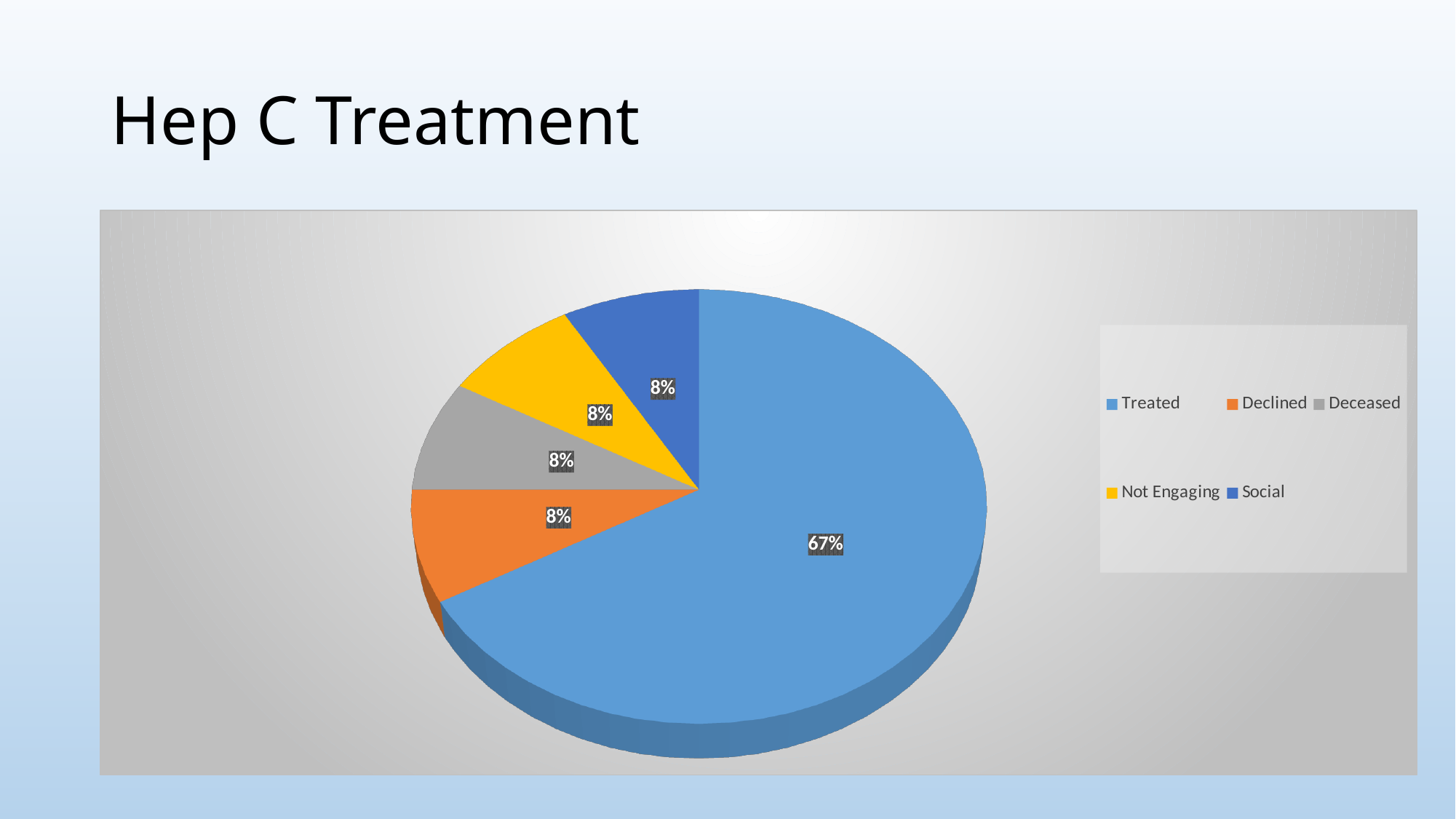
What share of the pie does the Deceased slice represent? 8% What colour is the Not Engaging slice? yellow What share of the pie does the Social slice represent? 8% What share of the pie does the Declined slice represent? 8% How many categories does the legend list? 5 Is the Treated share greater or less than 50%? greater What type of chart is shown on the slide? pie chart Which category has the largest slice of the pie? Treated Which is larger, the Treated slice or the Declined slice? Treated What is the difference between the Treated share and the Social share? 59%